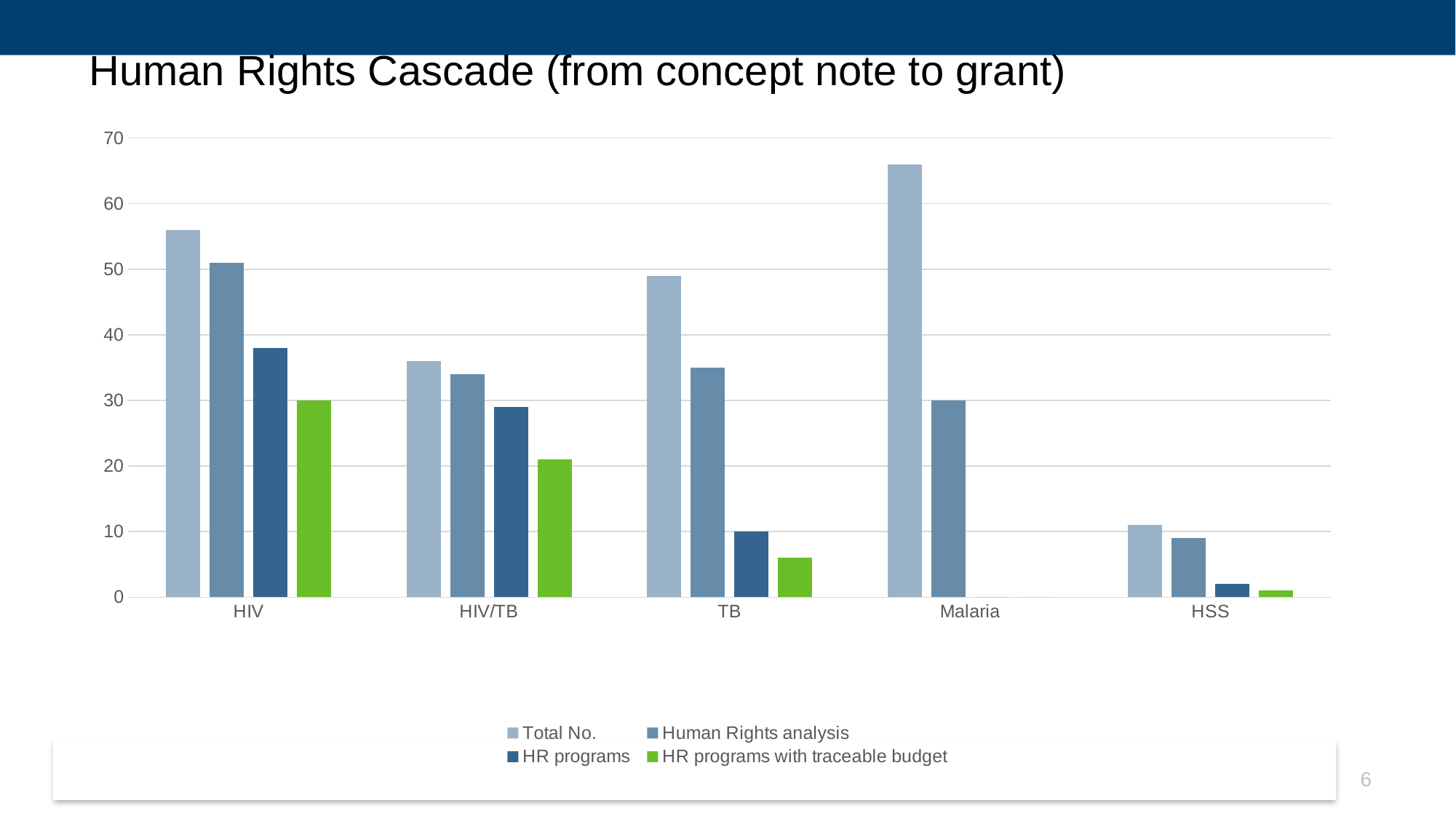
What is the title of the chart? Human Rights Cascade (from concept note to grant) Is the value for Total No. in Malaria greater or less than 60? greater How many series does the legend list? 4 How many categories are shown on the x axis? 5 Which is larger, the Total No. value for HIV or the Total No. value for TB? HIV Which category has the highest value for HR programs with traceable budget? HIV What kind of chart is shown on the slide? bar chart Which category has the highest value for Total No.? Malaria Which category has the lowest value for Total No.? HSS Which is larger, the HR programs value for HIV/TB or the HR programs value for TB? HIV/TB Is the value for HR programs in TB greater or less than 20? less